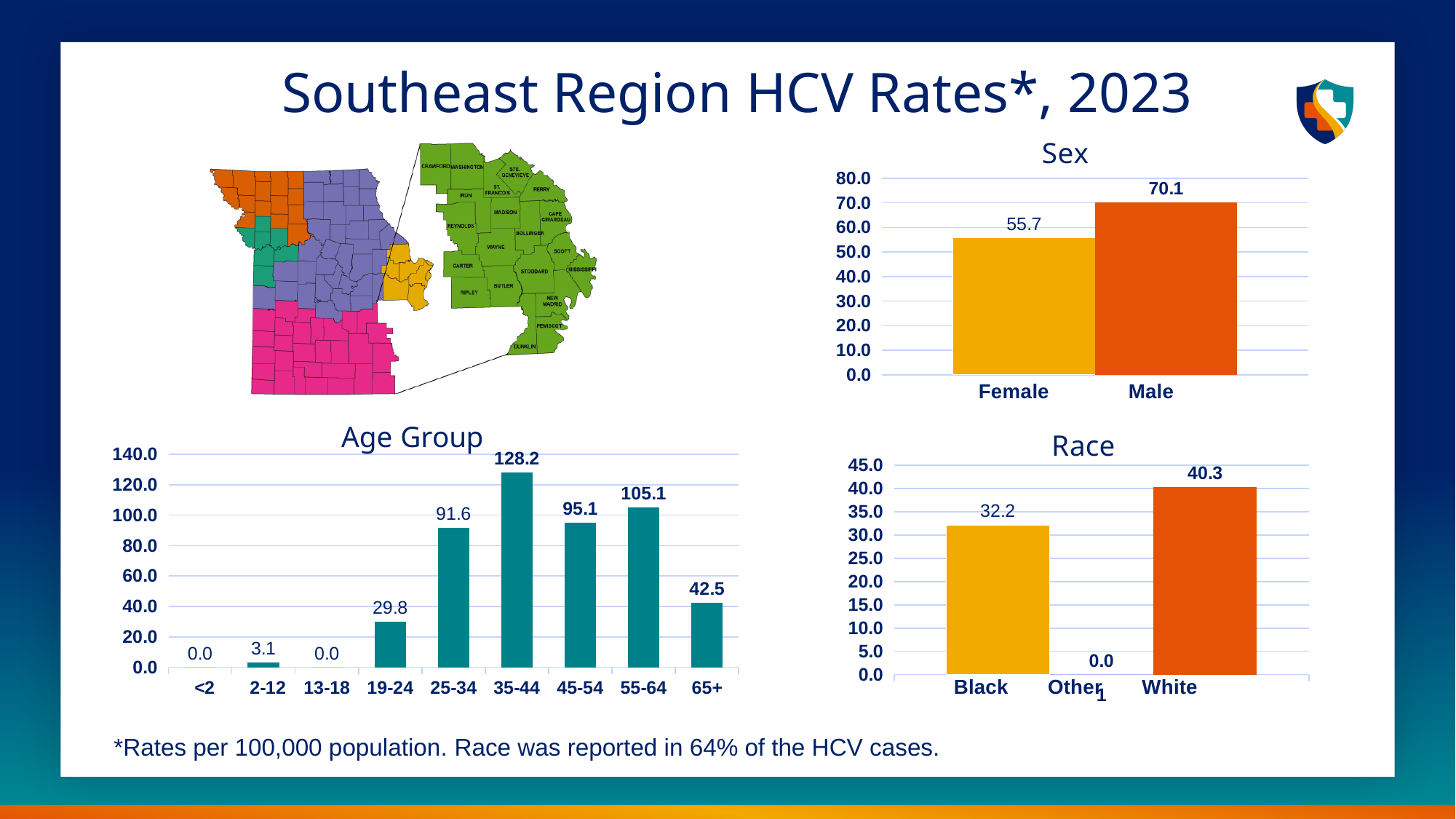
In the Age Group chart, what is the value for 55-64? 105.1 In the Age Group chart, what is the value for 19-24? 29.8 In the Sex chart, what is the value for Male? 70.1 In the Age Group chart, which age group has the highest rate? 35-44 In the Race chart, what is the value for White? 40.3 In the Sex chart, what is the difference between the Male and Female values? 14.4 What kind of chart is the Race chart? Bar chart In the Race chart, what is the difference between the White and Black values? 8.1 In the Race chart, which category has the lowest value? Other In the Age Group chart, which is larger, the value for 25-34 or the value for 45-54? 45-54 In the Sex chart, what is the value for Female? 55.7 In the Age Group chart, how many age group categories are shown on the x axis? 9